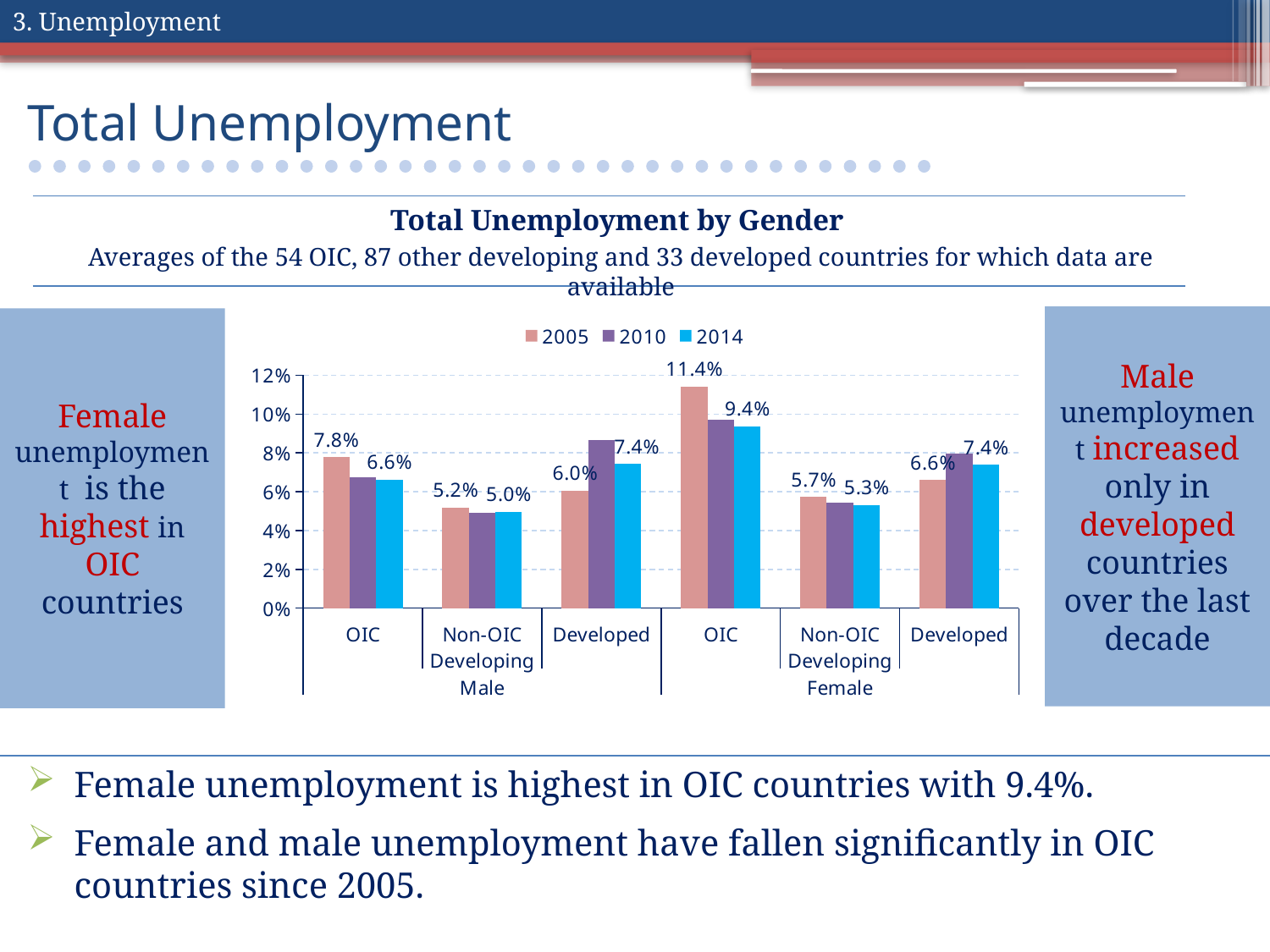
Which category group has the highest unemployment value in the chart? OIC (Female) Which is larger: male unemployment in OIC countries in 2005 or female unemployment in Developed countries in 2005? male unemployment in OIC countries in 2005 What kind of chart is shown on the slide? bar chart What was the female unemployment rate in OIC countries in 2005? 11.4% What is the title of the chart? Total Unemployment by Gender What was the male unemployment rate in Developed countries in 2005? 6.0% What was the male unemployment rate in OIC countries in 2014? 6.6% What was the female unemployment rate in Non-OIC Developing countries in 2014? 5.3% What is the difference between male unemployment in Developed countries in 2014 and in 2005? 1.4% How many series does the chart legend list? 3 Is the 2010 value for female unemployment in OIC countries greater or less than 8%? greater By how much did female unemployment in OIC countries fall between 2005 and 2014? 2.0%